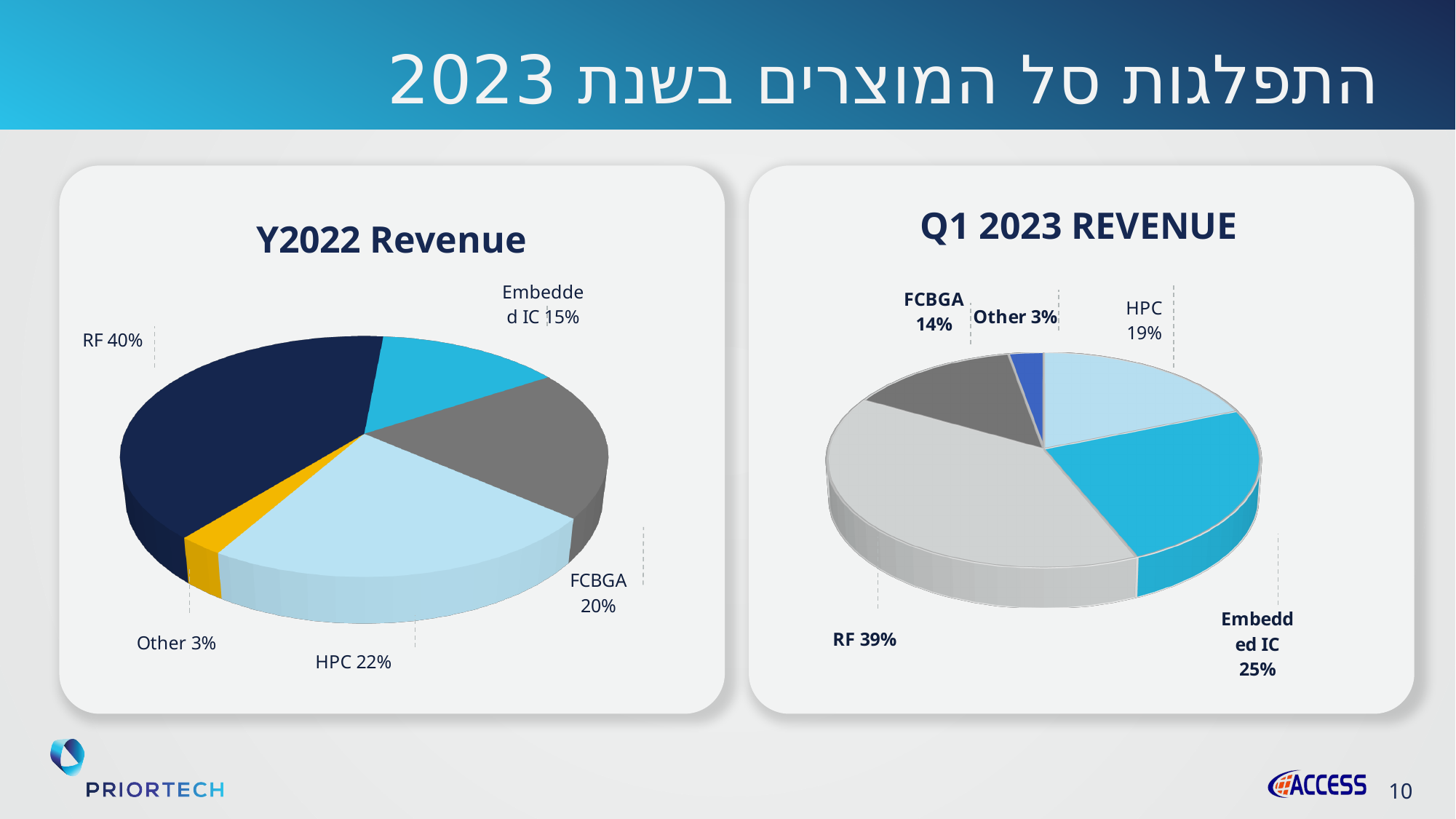
In the Y2022 Revenue chart, what share does RF have? 40% In the Y2022 Revenue chart, what is the difference between the RF share and the HPC share? 18% In the Q1 2023 REVENUE chart, what share does FCBGA have? 14% In the Q1 2023 REVENUE chart, which category has the largest share? RF What is the title of the chart on the left side of the slide? Y2022 Revenue How many categories are shown in the Y2022 Revenue chart? 5 In the Y2022 Revenue chart, what share does HPC have? 22% In the Y2022 Revenue chart, which category has the smallest share? Other In the Q1 2023 REVENUE chart, what share does Embedded IC have? 25% In the Q1 2023 REVENUE chart, what is the difference between the Embedded IC share and the HPC share? 6% In the Q1 2023 REVENUE chart, which is larger, the HPC share or the FCBGA share? HPC What type of chart is the Q1 2023 REVENUE chart? Pie chart